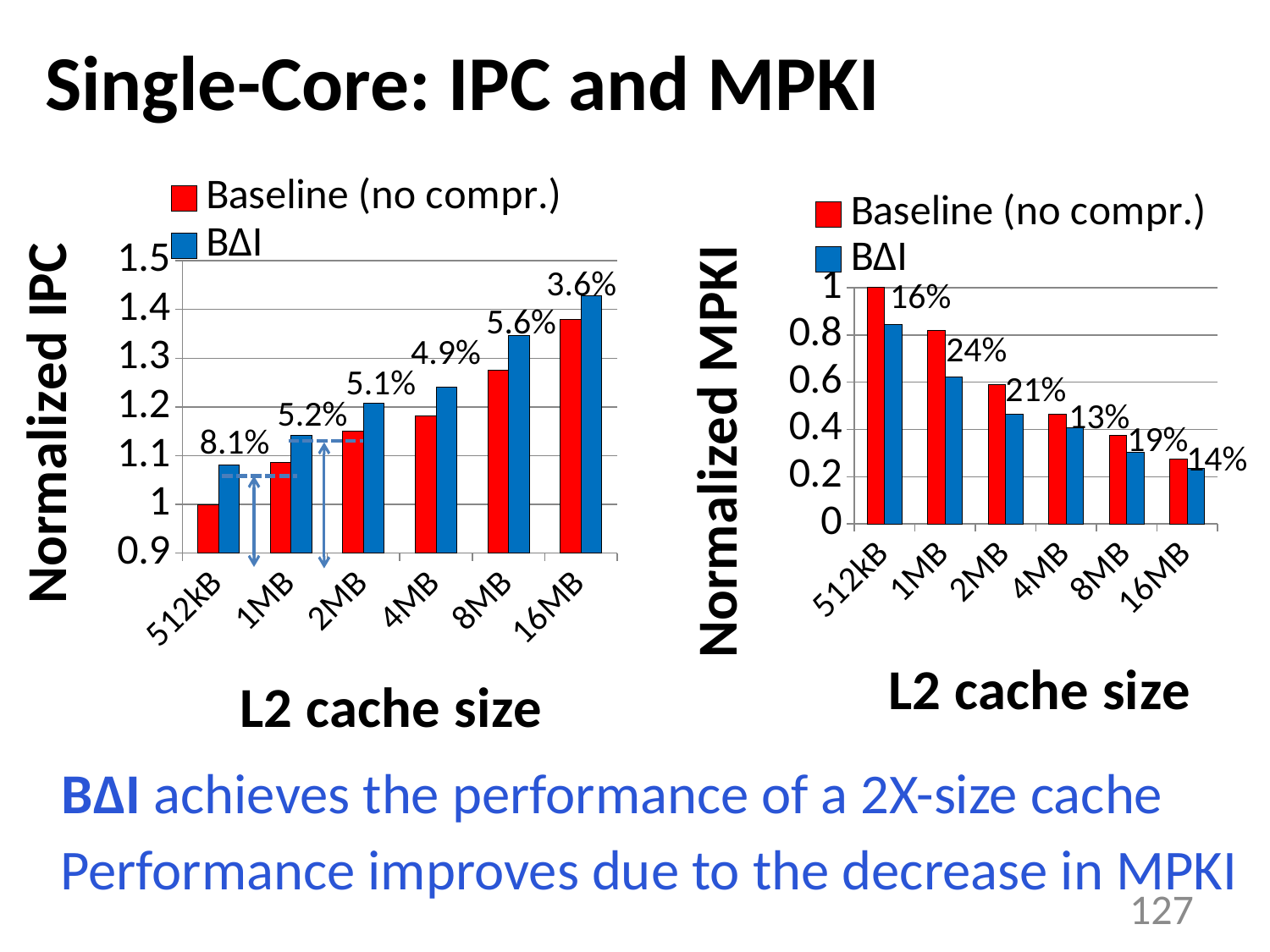
In the Normalized IPC chart, what is the Baseline (no compr.) value at 512kB? 1 How many series does the legend of the Normalized IPC chart list? 2 In the Normalized MPKI chart, what is the Baseline (no compr.) value at 512kB? 1 In the Normalized IPC chart, what percentage is annotated above the 512kB bars? 8.1% In the Normalized MPKI chart, do the values rise or fall as L2 cache size increases? fall In the Normalized MPKI chart, which series has the larger value at 1MB, Baseline (no compr.) or BΔI? Baseline (no compr.) In the Normalized IPC chart, is the BΔI value at 16MB greater or less than 1.4? greater In the Normalized IPC chart, do the values rise or fall as L2 cache size increases? rise What type of chart is the Normalized IPC chart on the left? bar chart In the Normalized MPKI chart, what percentage is annotated next to the 1MB bars? 24% In the Normalized MPKI chart, is the BΔI value at 512kB greater or less than 0.8? greater How many L2 cache size categories are shown on the Normalized MPKI chart on the right? 6